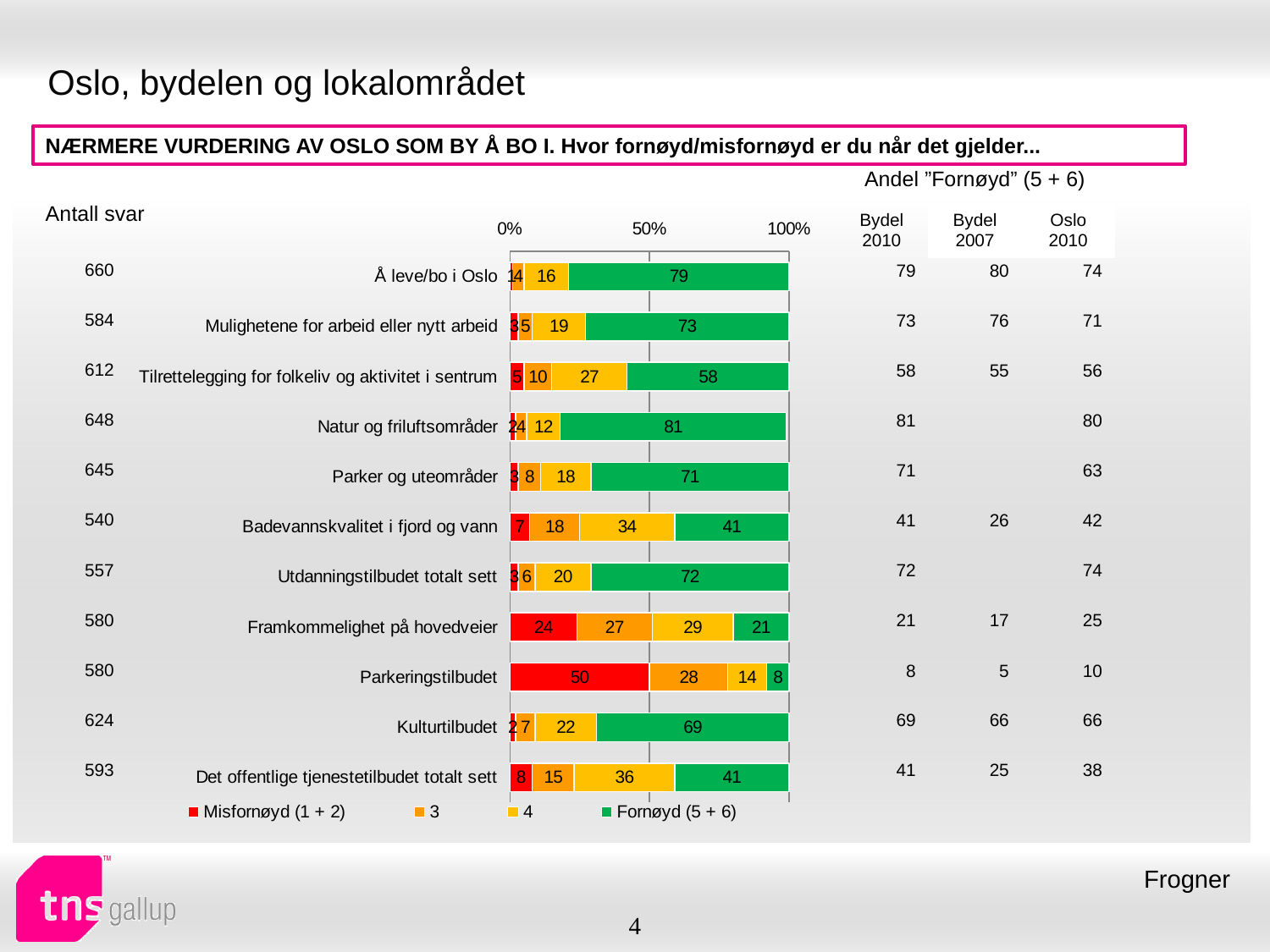
What is the value of series 3 for Framkommelighet på hovedveier? 27 How many series does the legend list? 4 How many categories are shown in the chart? 11 What is the Misfornøyd (1 + 2) value for Parkeringstilbudet? 50 Which has a larger Fornøyd (5 + 6) value, Mulighetene for arbeid eller nytt arbeid or Tilrettelegging for folkeliv og aktivitet i sentrum? Mulighetene for arbeid eller nytt arbeid Which category has the lowest Fornøyd (5 + 6) value? Parkeringstilbudet What is the total of the stacked bar for Parkeringstilbudet? 100 What kind of chart is shown on the slide? Stacked bar chart What is the difference between the Fornøyd (5 + 6) values for Å leve/bo i Oslo and Kulturtilbudet? 10 What is the Fornøyd (5 + 6) value for Natur og friluftsområder? 81 Which category has the highest Fornøyd (5 + 6) value? Natur og friluftsområder What is the value of series 4 for Badevannskvalitet i fjord og vann? 34